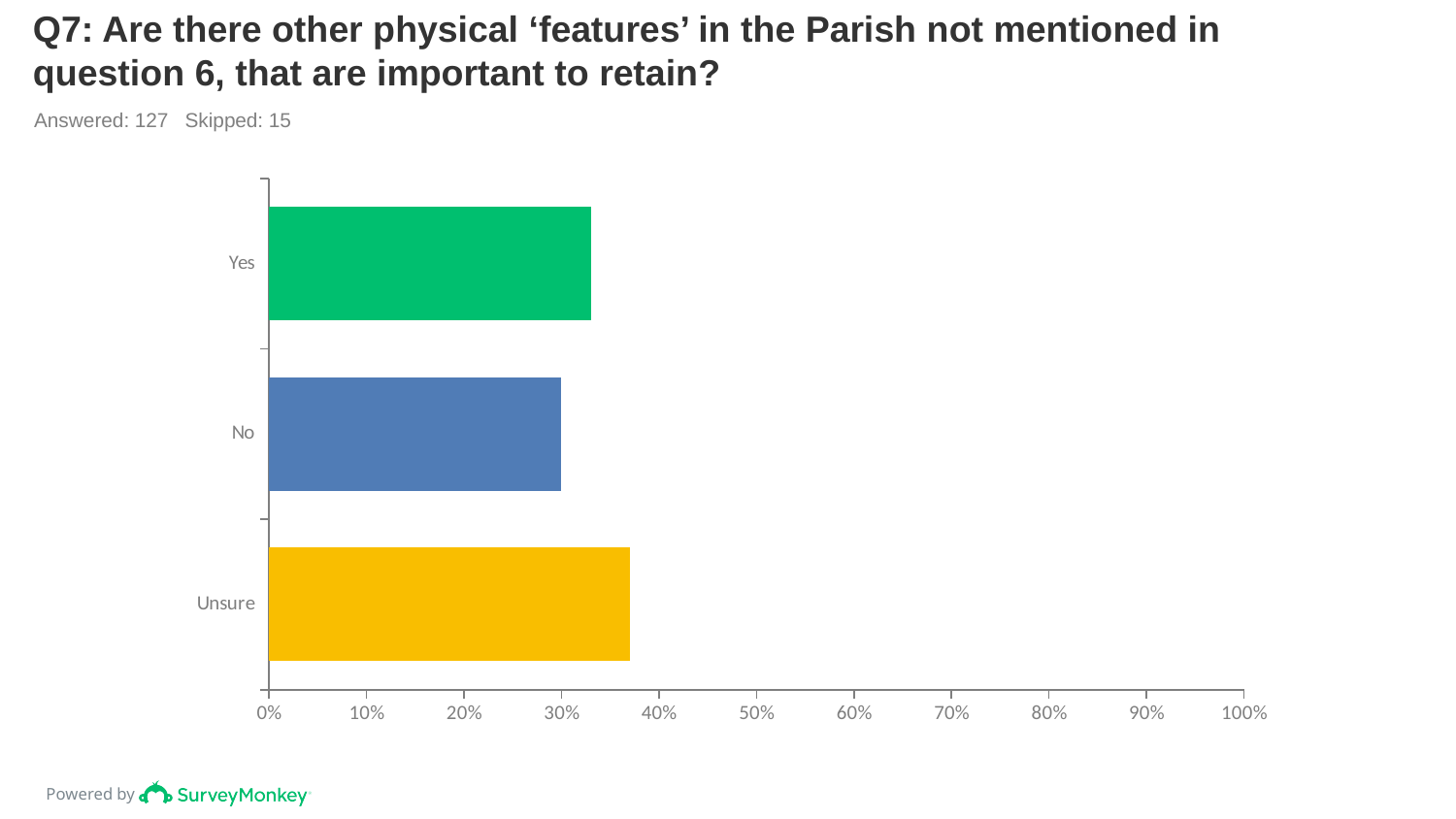
What colour is the bar for Unsure? yellow Which is larger, the value for Unsure or the value for Yes? Unsure Which is larger, the value for Yes or the value for No? Yes Is the value for Unsure greater or less than 40%? less Which response category has the highest value? Unsure Which response category has the lowest value? No Is the value for Yes greater or less than 40%? less Is the value for Yes greater or less than 30%? greater How many respondents answered this question according to the slide? 127 What kind of chart is shown on the slide? bar chart How many response categories are shown in the chart? 3